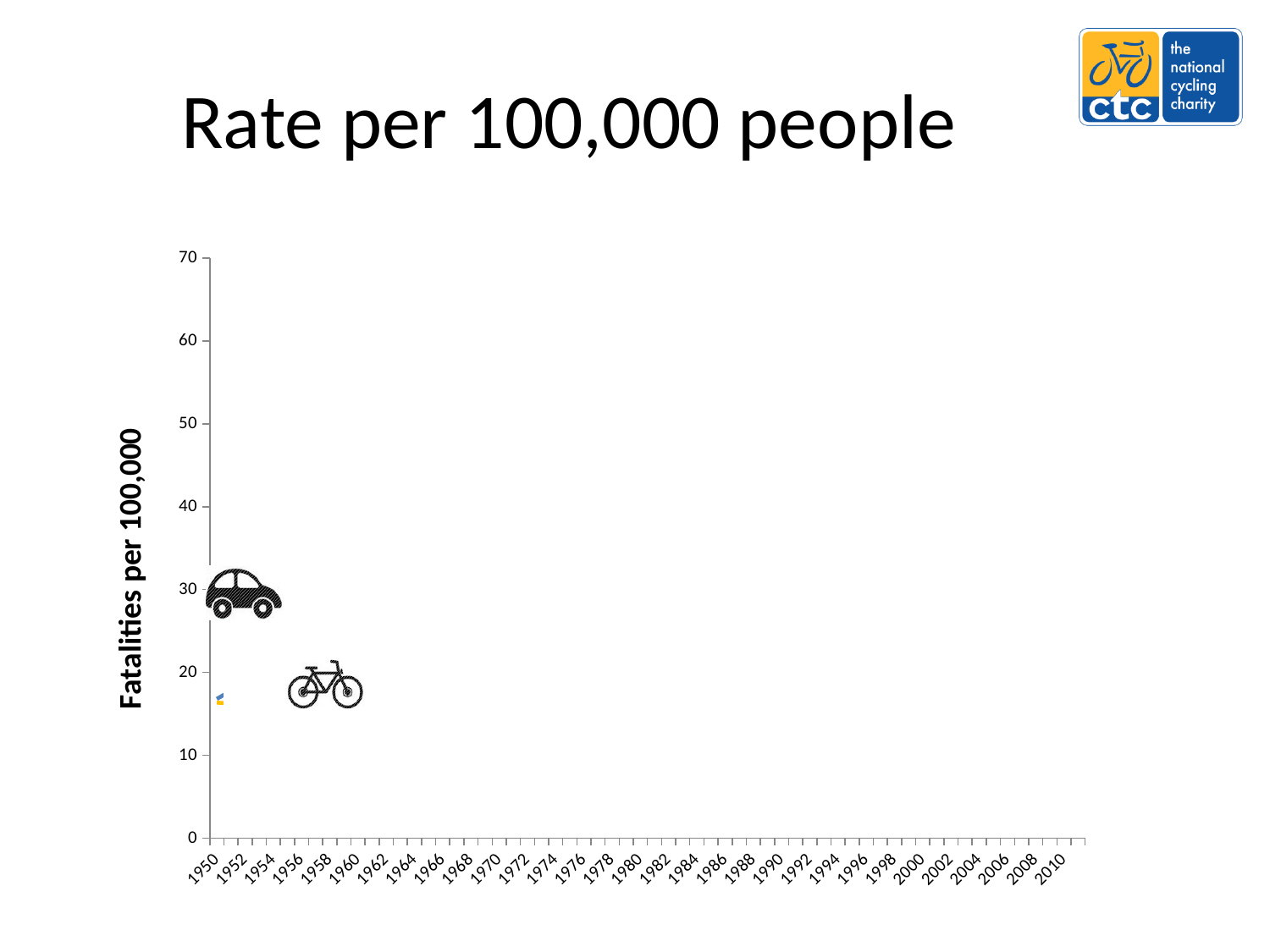
What is the title of the chart on the slide? Rate per 100,000 people Is the value plotted at 1950 greater or less than 10? greater Is the value plotted at 1950 greater or less than 20? less What is the label on the vertical axis of the chart? Fatalities per 100,000